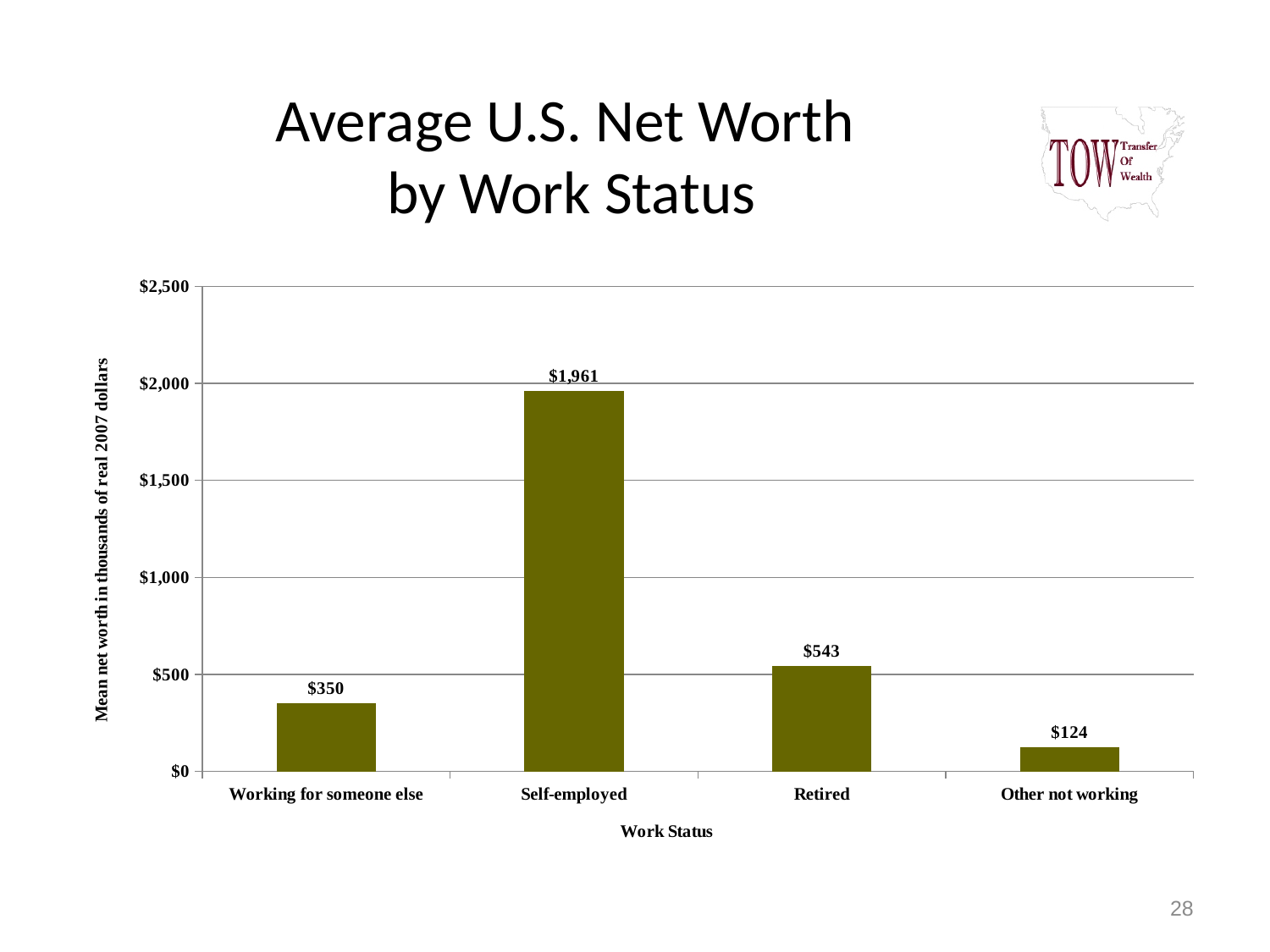
What kind of chart is shown on the slide? Bar chart Which work status has the lowest mean net worth? Other not working Which work status has the highest mean net worth? Self-employed What is the mean net worth for Working for someone else? $350 How many work status categories are shown in the chart? 4 What is the difference in mean net worth between Self-employed and Retired? $1,418 What is the mean net worth for Self-employed? $1,961 What is the mean net worth for Other not working? $124 What is the difference in mean net worth between Retired and Working for someone else? $193 Is the value for Self-employed greater or less than $1,500? greater What is the mean net worth for Retired? $543 Which has a larger mean net worth, Retired or Working for someone else? Retired